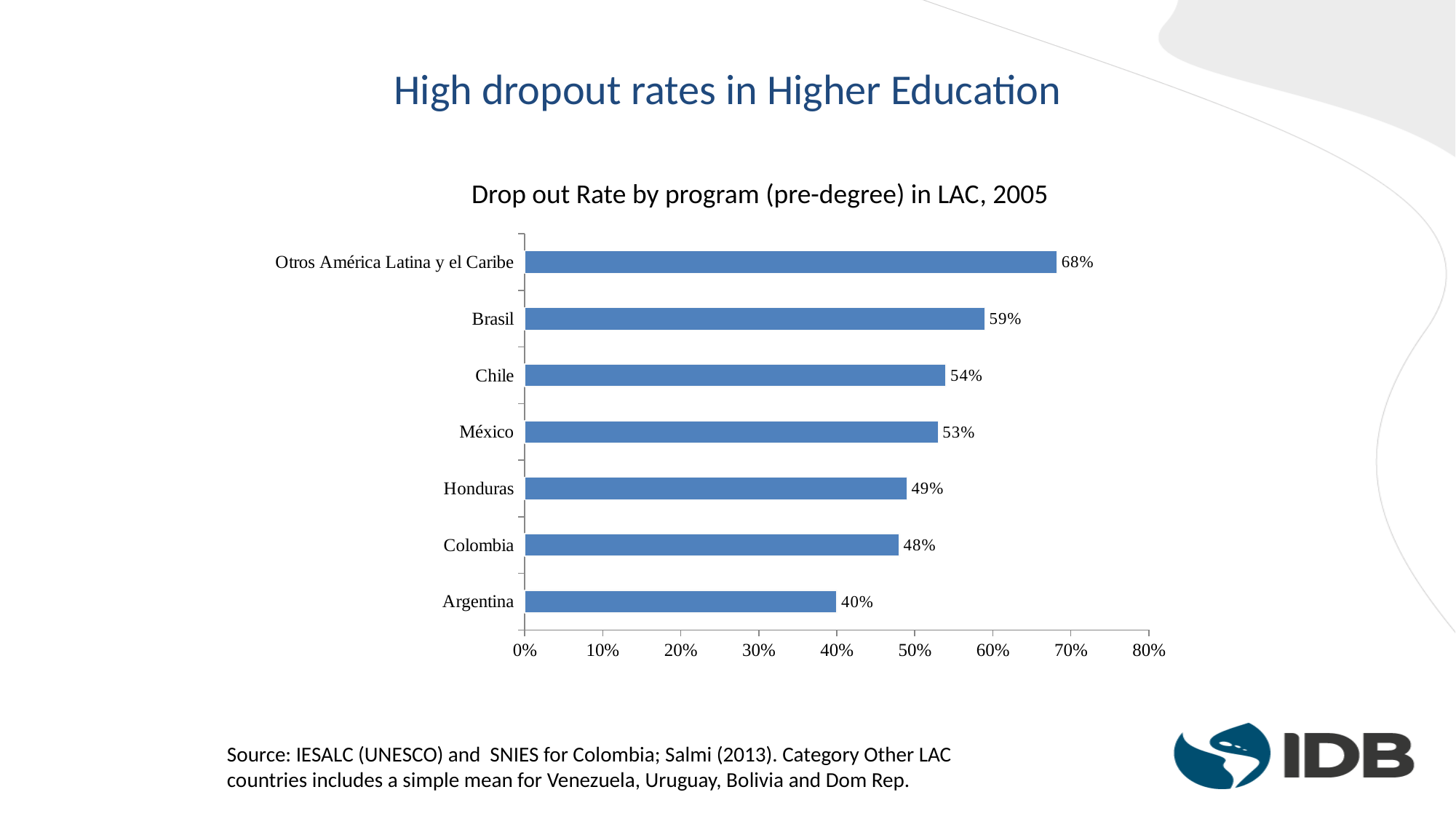
What kind of chart is shown on the slide? Bar chart Which has a higher dropout rate, Chile or Honduras? Chile What is the difference between the dropout rates of Brasil and Argentina? 19% What is the difference between the dropout rates of Chile and Colombia? 6% Which country has the lowest dropout rate? Argentina Is the dropout rate for México greater or less than 50%? greater Which category has the highest dropout rate? Otros América Latina y el Caribe What is the dropout rate for Argentina? 40% What is the dropout rate for Honduras? 49% What is the dropout rate for Brasil? 59% What is the title of the chart? Drop out Rate by program (pre-degree) in LAC, 2005 How many categories are shown in the chart? 7